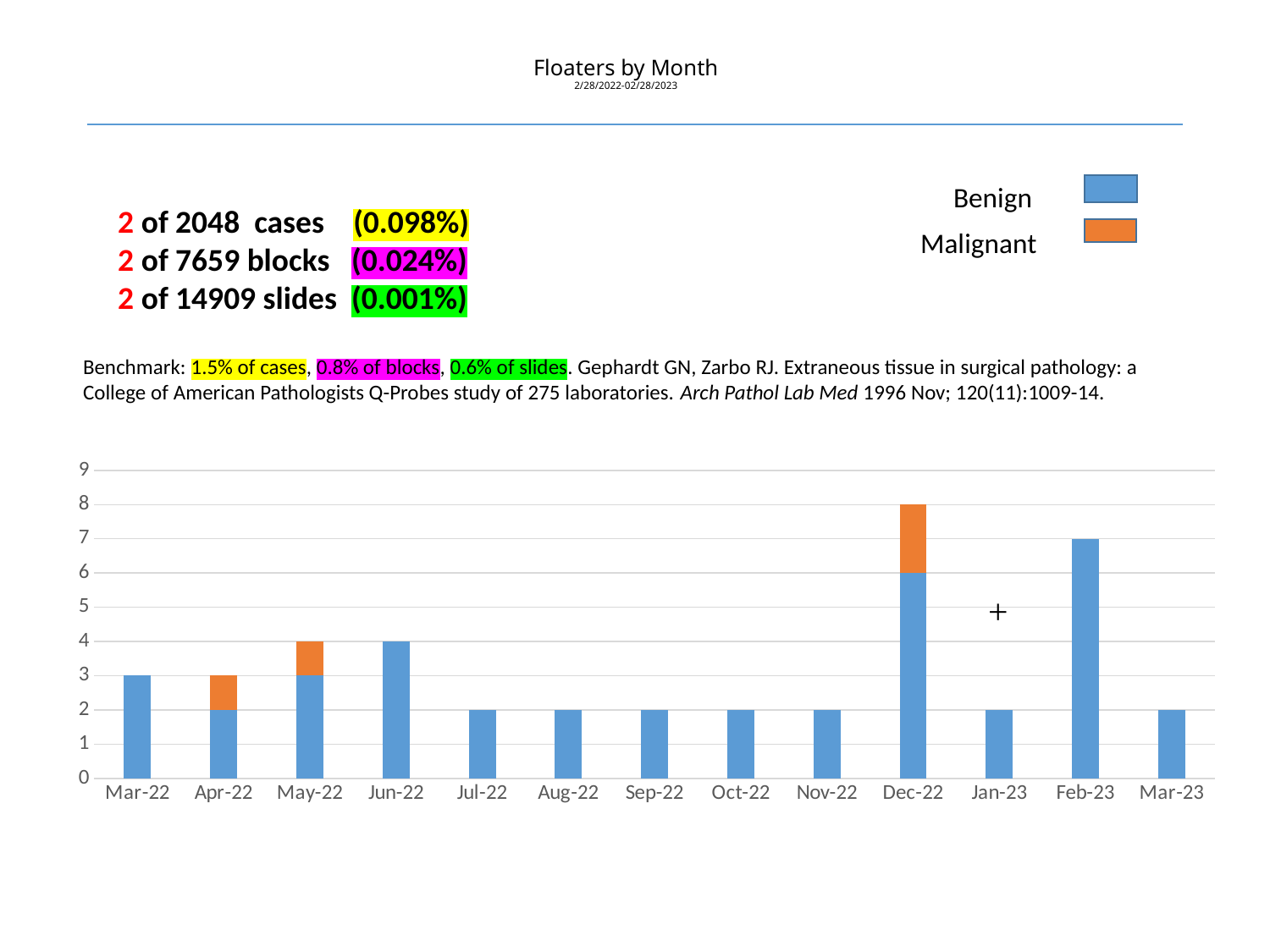
What is the Malignant value for Dec-22? 2 What is the Benign value for Apr-22? 2 Which month has the highest total bar? Dec-22 What is the Benign value for Feb-23? 7 How many months are shown on the x axis of the chart? 13 What kind of chart is shown on the slide? Stacked bar chart How many series does the legend list? 2 Which is larger, the Benign value for Jun-22 or the Benign value for May-22? Jun-22 Is the total bar for Feb-23 greater or less than 5? greater What is the difference between the total bar for Dec-22 and the total bar for Feb-23? 1 What is the total height of the stacked bar for Dec-22? 8 Which colour represents the Malignant series in the chart? Orange